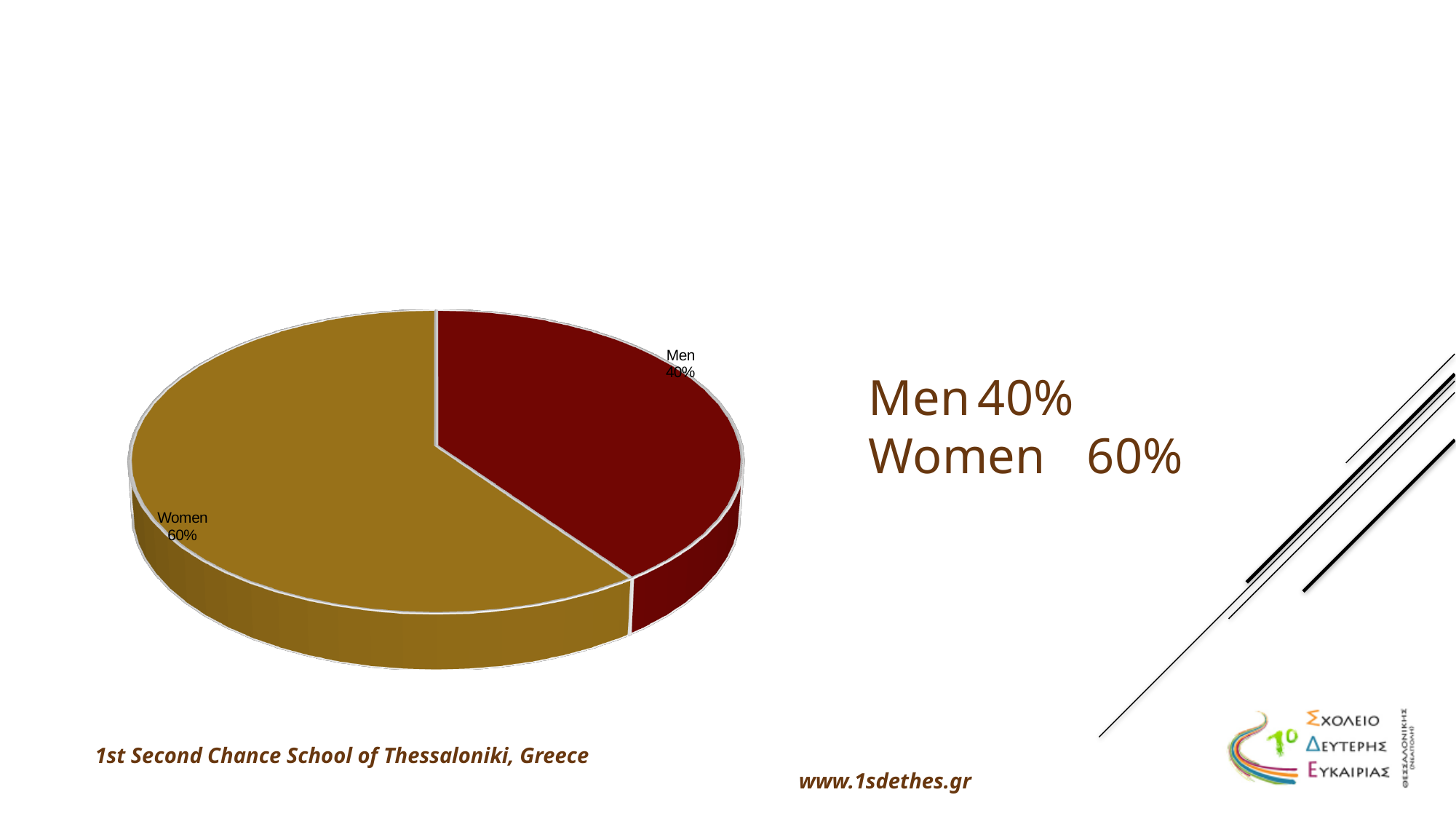
How many slices does the pie chart have? 2 What share of the pie does the Women slice represent? 60% Which is larger, the Men slice or the Women slice? Women What colour is the Men slice of the pie? dark red Is the share for Women greater or less than 50%? greater Which slice of the pie is the largest? Women What share of the pie does the Men slice represent? 40% What is the difference in percentage points between the Women slice and the Men slice? 20 percentage points What colour is the Women slice of the pie? gold Which slice of the pie is the smallest? Men What kind of chart is shown on the slide? pie chart